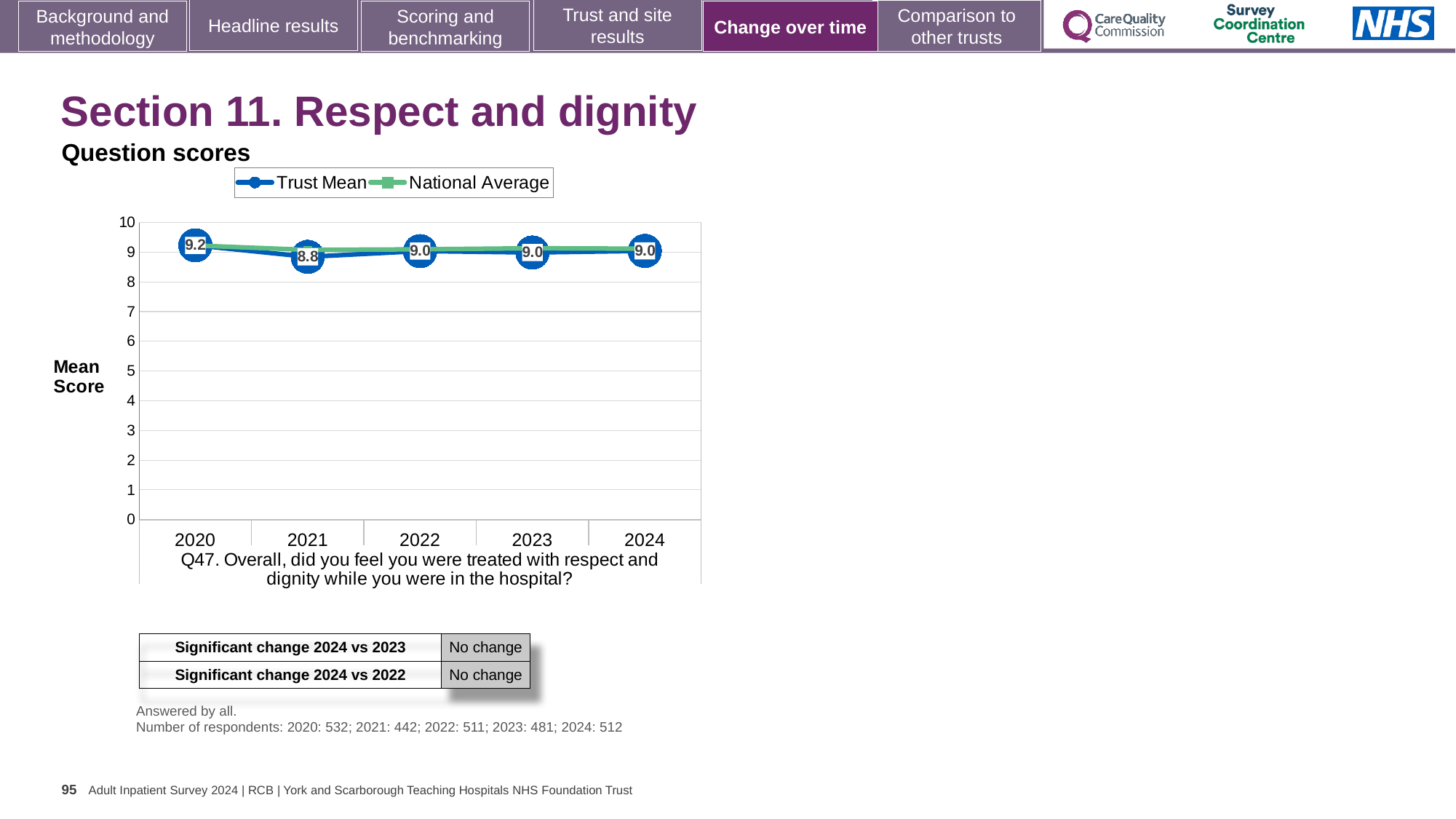
How many series does the legend list? 2 How many years are plotted on the x axis? 5 Is the National Average value for 2021 greater or less than 8? greater In which year is the Trust Mean score highest? 2020 What is the Trust Mean score for 2024? 9.0 What is the difference between the Trust Mean scores for 2020 and 2021? 0.4 What is the Trust Mean score for 2020? 9.2 Does the Trust Mean score rise or fall from 2020 to 2021? Fall What kind of chart is shown? Line chart In which year is the Trust Mean score lowest? 2021 Which is larger, the Trust Mean score for 2020 or for 2021? 2020 What is the Trust Mean score for 2021? 8.8